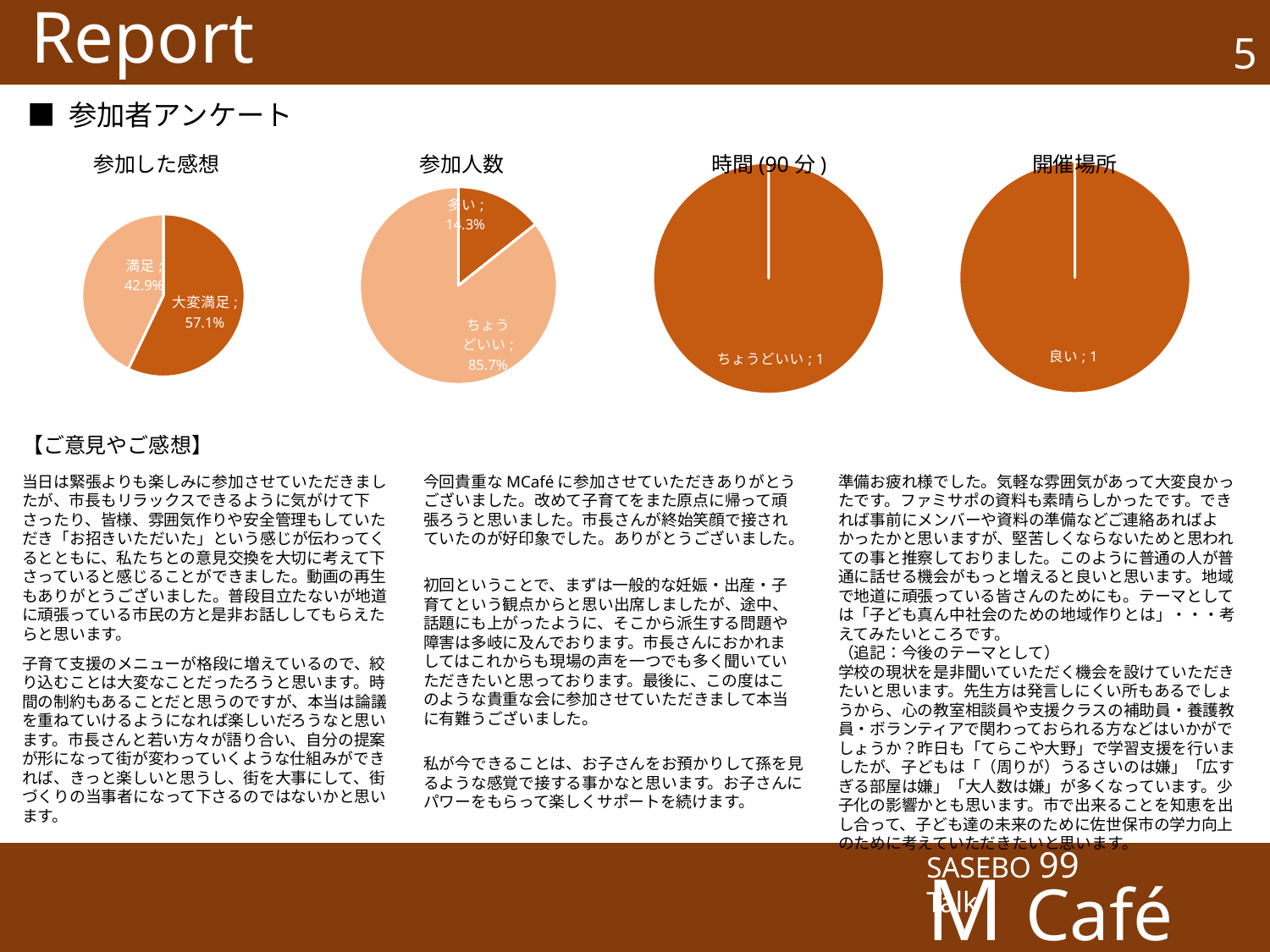
In the 参加人数 chart, which slice is the smallest? 多い How many charts are shown on the slide? 4 In the 参加人数 chart, how many slices are there? 2 In the 参加した感想 chart, what is the difference between the 大変満足 and 満足 shares? 14.2% In the 開催場所 chart, what is the label on the single slice? 良い ; 1 In the 時間 (90 分 ) chart, what is the label on the single slice? ちょうどいい ; 1 In the 参加した感想 chart, what share is labelled 満足? 42.9% What kind of chart is used for 参加した感想? pie chart In the 参加人数 chart, what share is labelled ちょうどいい? 85.7% In the 参加した感想 chart, what share is labelled 大変満足? 57.1% In the 参加した感想 chart, which slice is larger, 満足 or 大変満足? 大変満足 In the 参加人数 chart, what share is labelled 多い? 14.3%